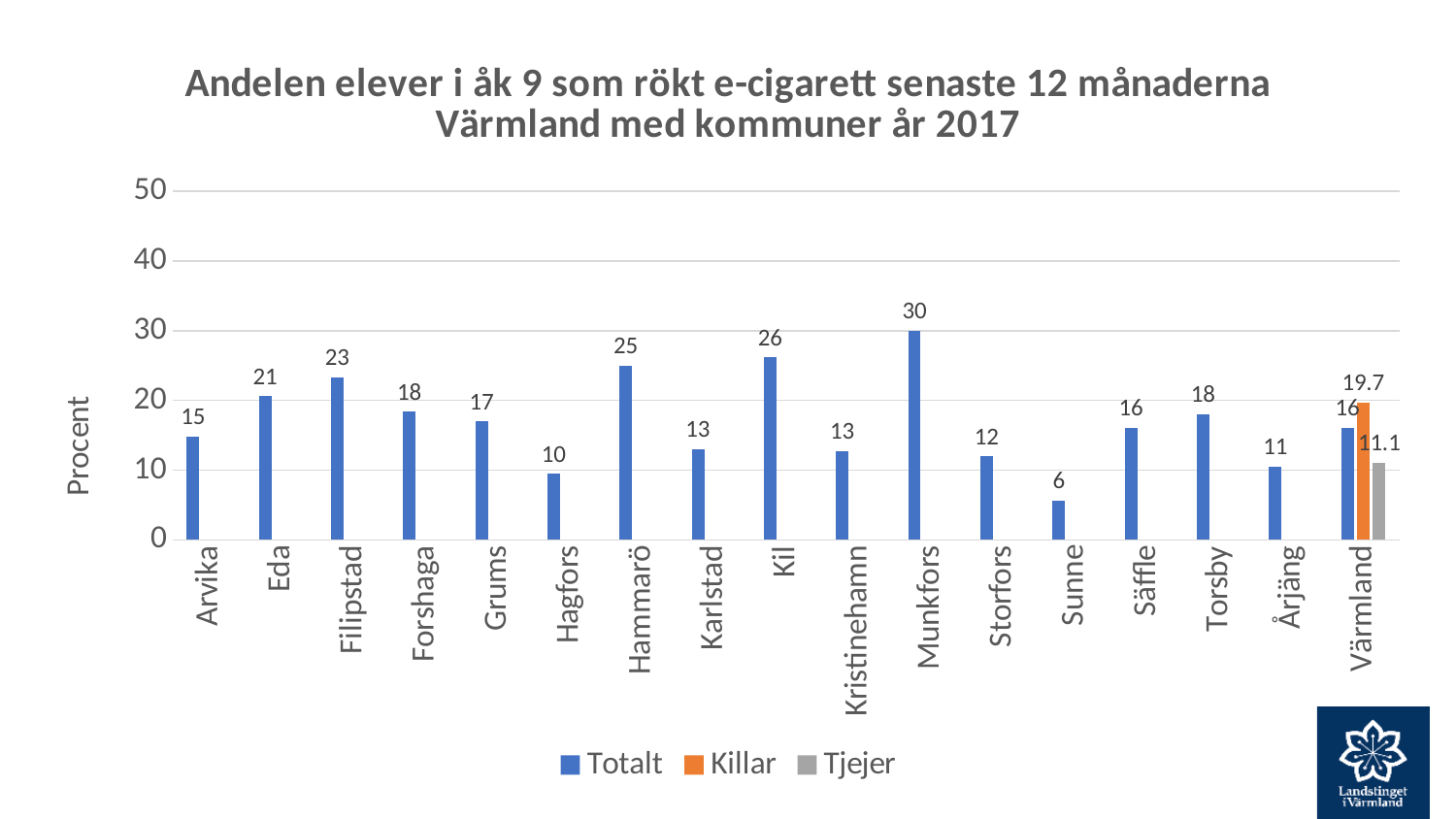
What is the difference between the Totalt values for Kil and Hagfors? 16 Which municipality has the lowest Totalt value? Sunne Which has a higher Totalt value, Eda or Forshaga? Eda What is the Totalt value for Munkfors? 30 Is the Totalt value for Hammarö greater or less than 20? greater What is the Killar value for Värmland? 19.7 How many series does the legend list? 3 Which municipality has the highest Totalt value? Munkfors What is the Tjejer value for Värmland? 11.1 What is the label of the y axis? Procent What kind of chart is shown on the slide? bar chart How many categories are shown on the x axis? 17